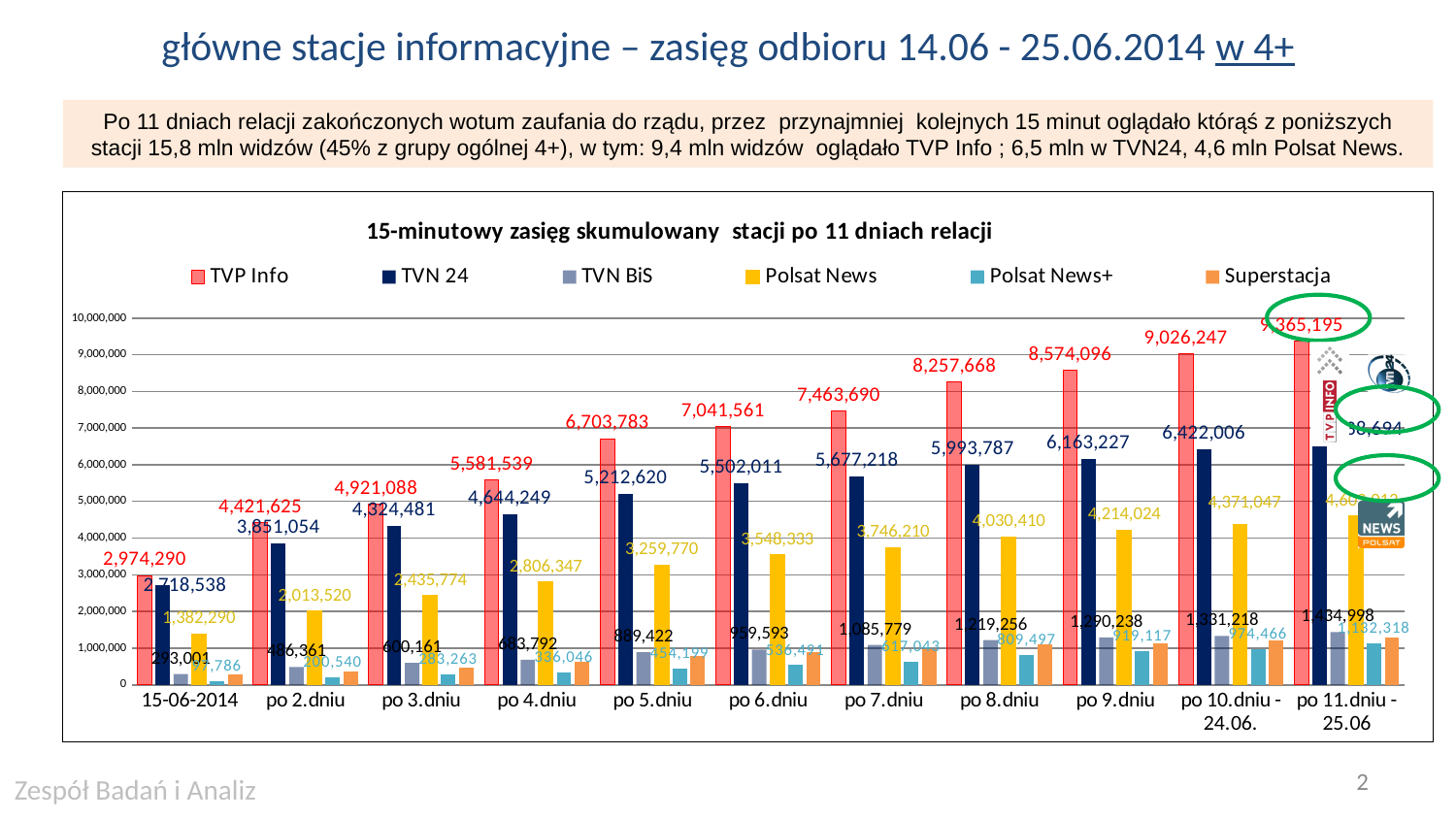
How many categories are shown along the x axis of the chart? 11 How many series does the chart legend list? 6 What kind of chart is shown on the slide? bar chart What is the difference between the TVP Info values at 'po 9.dniu' and 'po 8.dniu'? 316,428 What is the value for TVP Info at 'po 8.dniu'? 8,257,668 What is the value for TVN 24 at 'po 10.dniu - 24.06.'? 6,422,006 Do the TVP Info values rise or fall from left to right along the x axis? rise What is the value for TVP Info at '15-06-2014'? 2,974,290 What is the value for Polsat News at 'po 5.dniu'? 3,259,770 At 'po 7.dniu', which is larger: TVN 24 or Polsat News? TVN 24 Is the value for TVN 24 at 'po 11.dniu - 25.06' greater or less than 6,000,000? greater Which series has the highest value at 'po 11.dniu - 25.06'? TVP Info